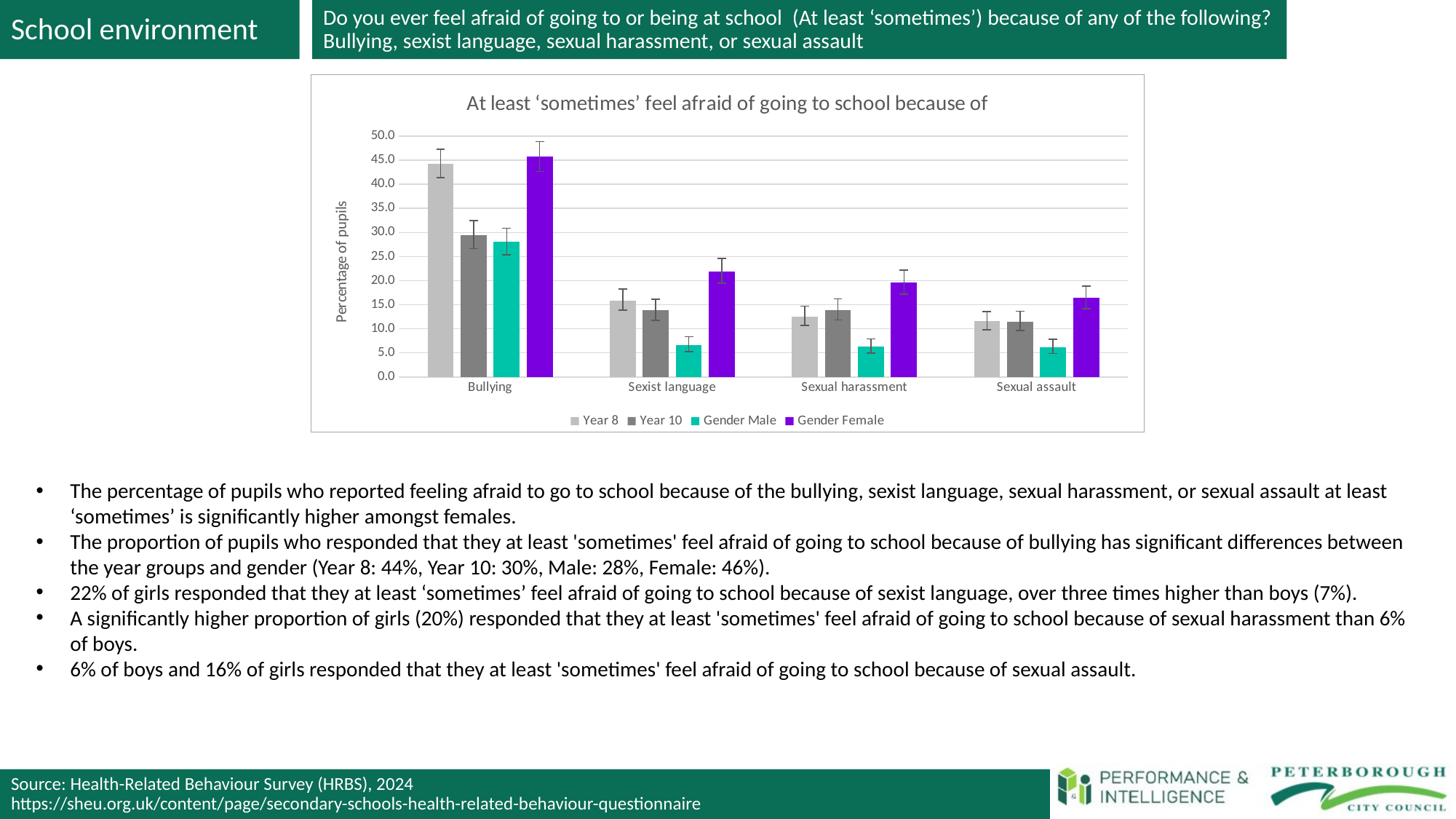
Which series is shown in purple in the chart? Gender Female Is the value for Year 8 in the Bullying category greater or less than 40.0? greater How many categories are shown on the x axis of the chart? 4 Is the value for Gender Male in the Sexual assault category greater or less than 10.0? less Which series has the highest value in the Sexist language category? Gender Female Is the value for Gender Female in the Sexist language category greater or less than 20.0? greater What is the title of the chart's vertical axis? Percentage of pupils What kind of chart is shown on the slide? Bar chart Which series has the lowest value in the Sexual harassment category? Gender Male How many series does the chart's legend list? 4 In the Bullying category, which is larger: the value for Year 8 or the value for Gender Male? Year 8